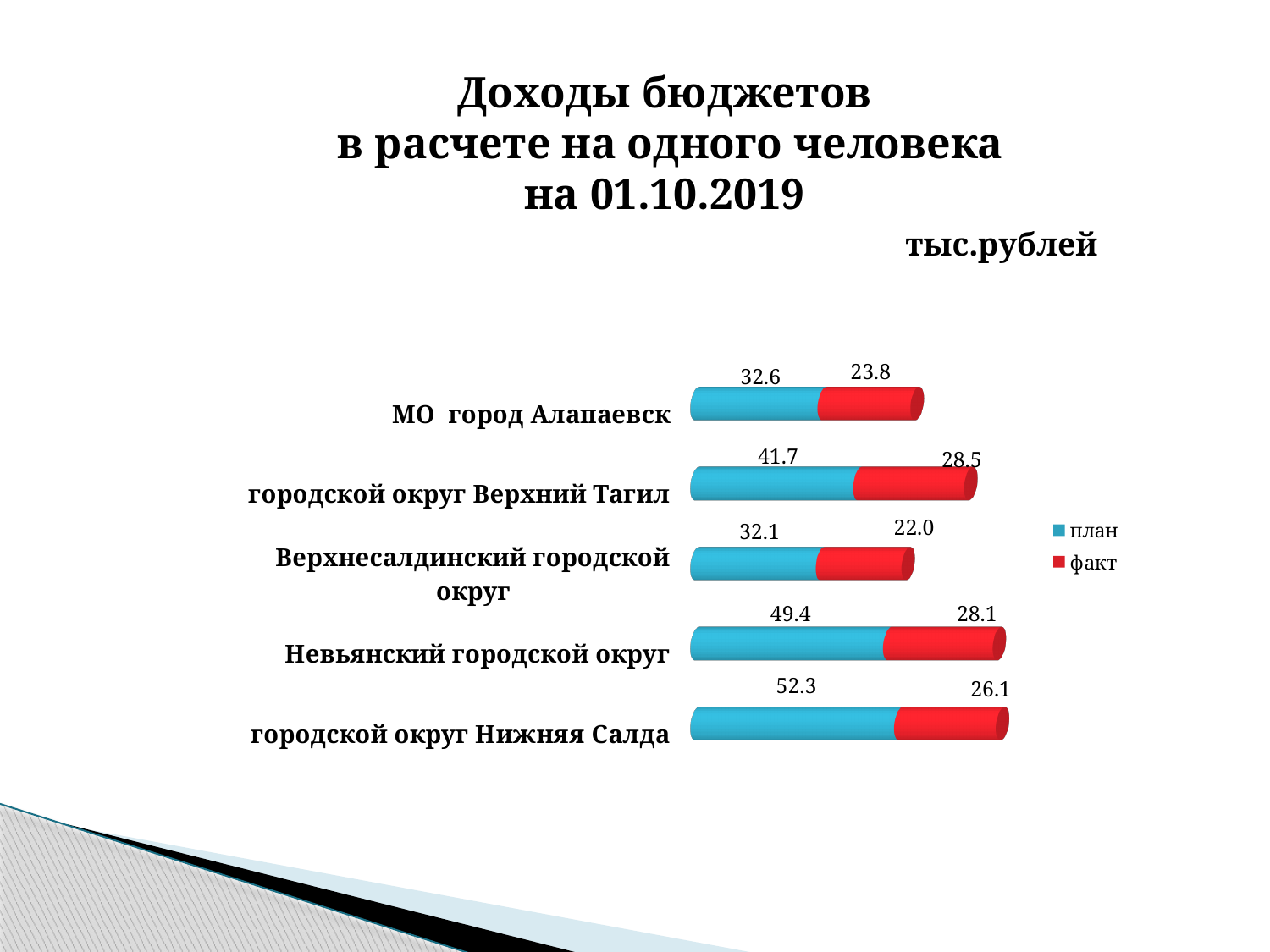
Which is larger: the план value for городской округ Верхний Тагил or the план value for МО город Алапаевск? городской округ Верхний Тагил Which category has the highest план value? городской округ Нижняя Салда What is the факт value for Верхнесалдинский городской округ? 22.0 What kind of chart is shown on the slide? bar chart How many series does the legend list? 2 What is the факт value for МО город Алапаевск? 23.8 What is the total of the stacked bar for городской округ Верхний Тагил? 70.2 How many categories are shown in the chart? 5 Which category has the lowest факт value? Верхнесалдинский городской округ What is the план value for городской округ Нижняя Салда? 52.3 Which category has the highest факт value? городской округ Верхний Тагил What is the difference between the план and факт values for Невьянский городской округ? 21.3